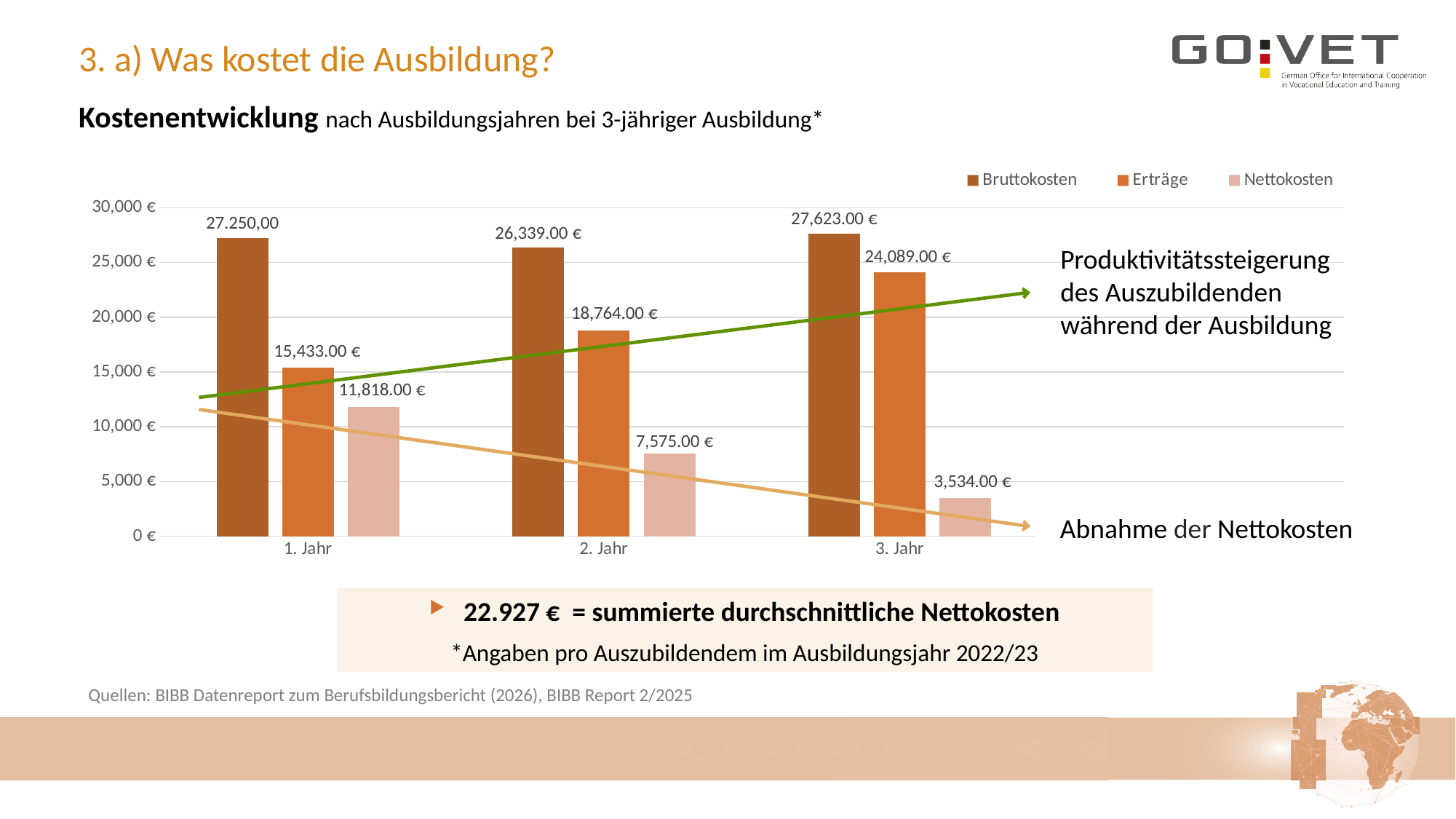
What is the difference between Nettokosten in 1. Jahr and Nettokosten in 3. Jahr? 8,284.00 € Is the value of Erträge for 1. Jahr greater or less than 20,000 €? less What is the value of Erträge for 2. Jahr? 18,764.00 € How many series does the legend list? 3 What is the value of Bruttokosten for 3. Jahr? 27,623.00 € What is the value of Nettokosten for 1. Jahr? 11,818.00 € What is the difference between Erträge in 3. Jahr and Erträge in 1. Jahr? 8,656.00 € In which year are the Erträge highest? 3. Jahr Do the Nettokosten rise or fall from 1. Jahr to 3. Jahr? fall In which year are the Nettokosten lowest? 3. Jahr Which is larger: Erträge in 2. Jahr or Nettokosten in 2. Jahr? Erträge in 2. Jahr How many years (categories) are shown on the x axis? 3